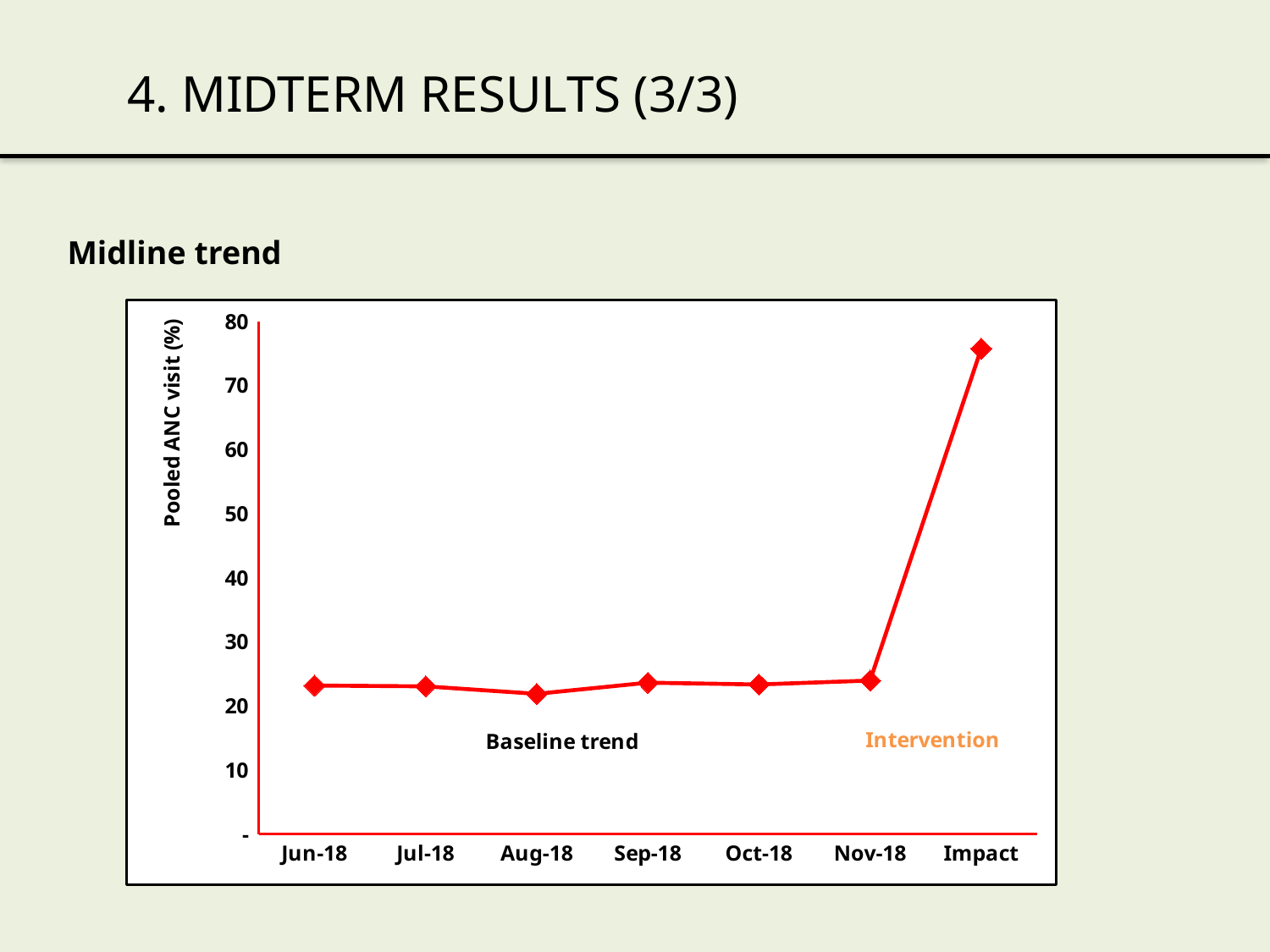
Which is larger, the value for Sep-18 or the value for Impact? Impact What kind of chart is shown on the slide? line chart How many points are plotted along the x axis? 7 What is the label on the y axis? Pooled ANC visit (%) What text label appears in orange near the right side of the plot area? Intervention Is the value for Nov-18 greater or less than 20? greater Which x-axis category has the highest pooled ANC visit value? Impact Is the value for Jun-18 greater or less than 30? less Is the value for Aug-18 greater or less than 30? less Which is larger, the value for Impact or the value for Nov-18? Impact Does the line rise or fall between Nov-18 and Impact? rise